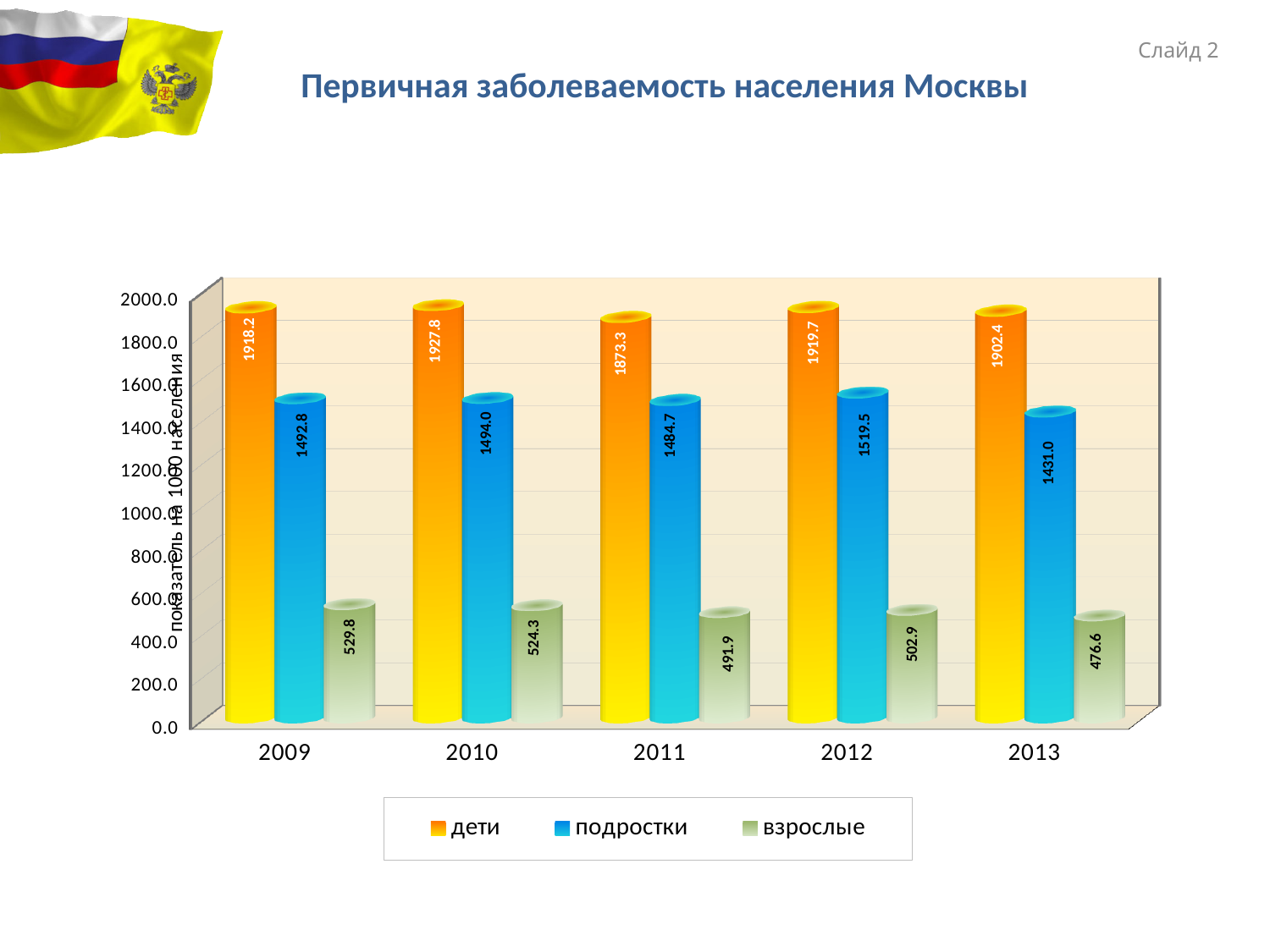
In which year is the value for дети the highest? 2010 In which year is the value for взрослые the lowest? 2013 What is the difference between the дети value and the подростки value in 2012? 400.2 How many series does the legend list? 3 Which is larger: the взрослые value in 2009 or in 2012? 2009 What kind of chart is shown on the slide? bar chart What is the title of the chart on the slide? Первичная заболеваемость населения Москвы What is the value for дети in 2010? 1927.8 How many years are shown on the x axis? 5 What is the value for взрослые in 2011? 491.9 What is the value for подростки in 2013? 1431.0 Does the value for взрослые rise or fall from 2012 to 2013? fall